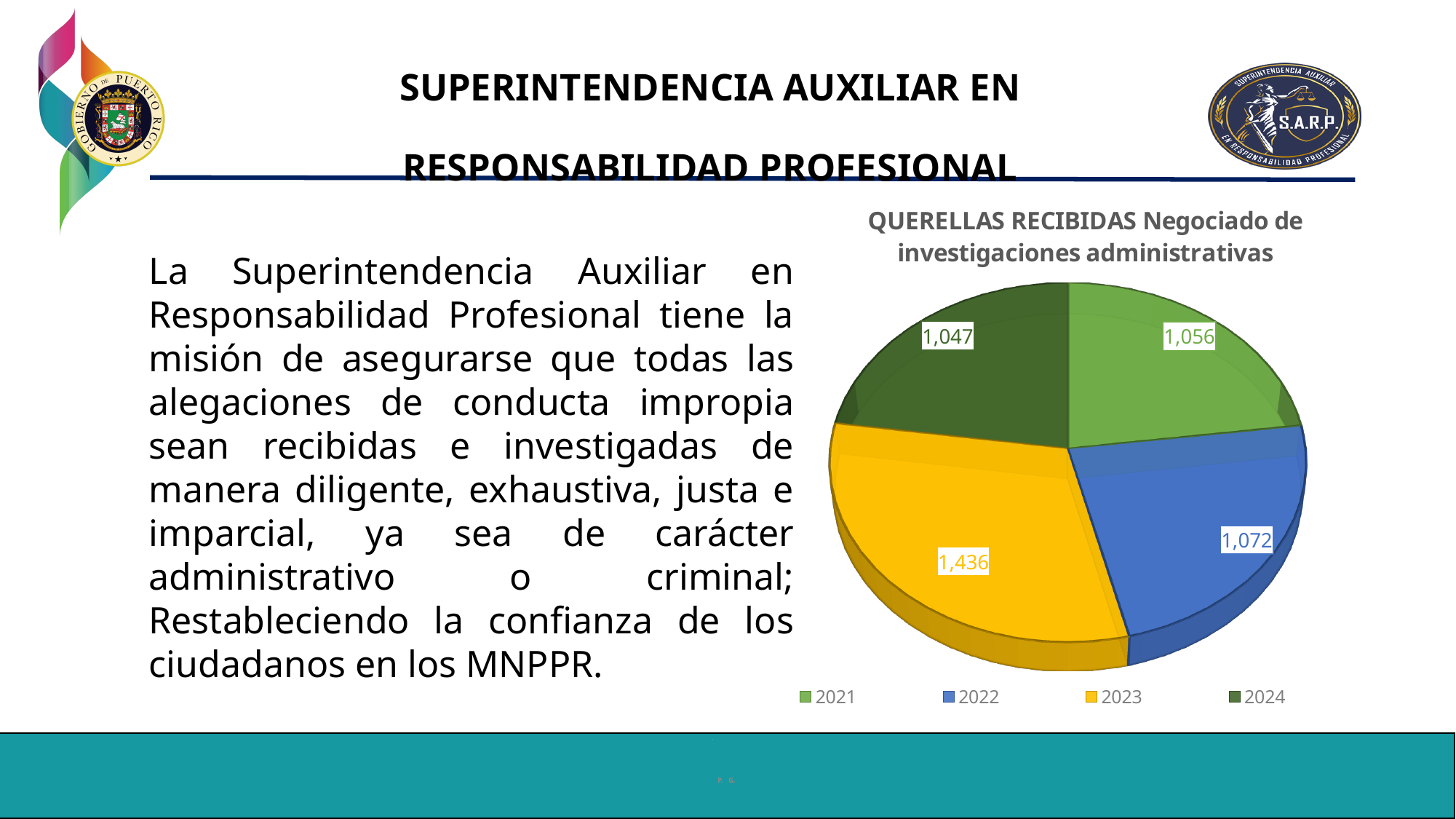
Which year has the smallest slice in the pie chart? 2024 What is the value for 2023 in the pie chart? 1,436 How many slices does the pie chart have? 4 What is the value for 2021 in the pie chart? 1,056 What is the difference between the values for 2023 and 2022? 364 What is the title of the pie chart? QUERELLAS RECIBIDAS Negociado de investigaciones administrativas Which is larger, the value for 2021 or the value for 2024? 2021 What kind of chart is shown on the slide? Pie chart Which year has the largest slice in the pie chart? 2023 What is the value for 2024 in the pie chart? 1,047 What is the difference between the values for 2022 and 2021? 16 What is the total of all slices in the pie chart? 4,611